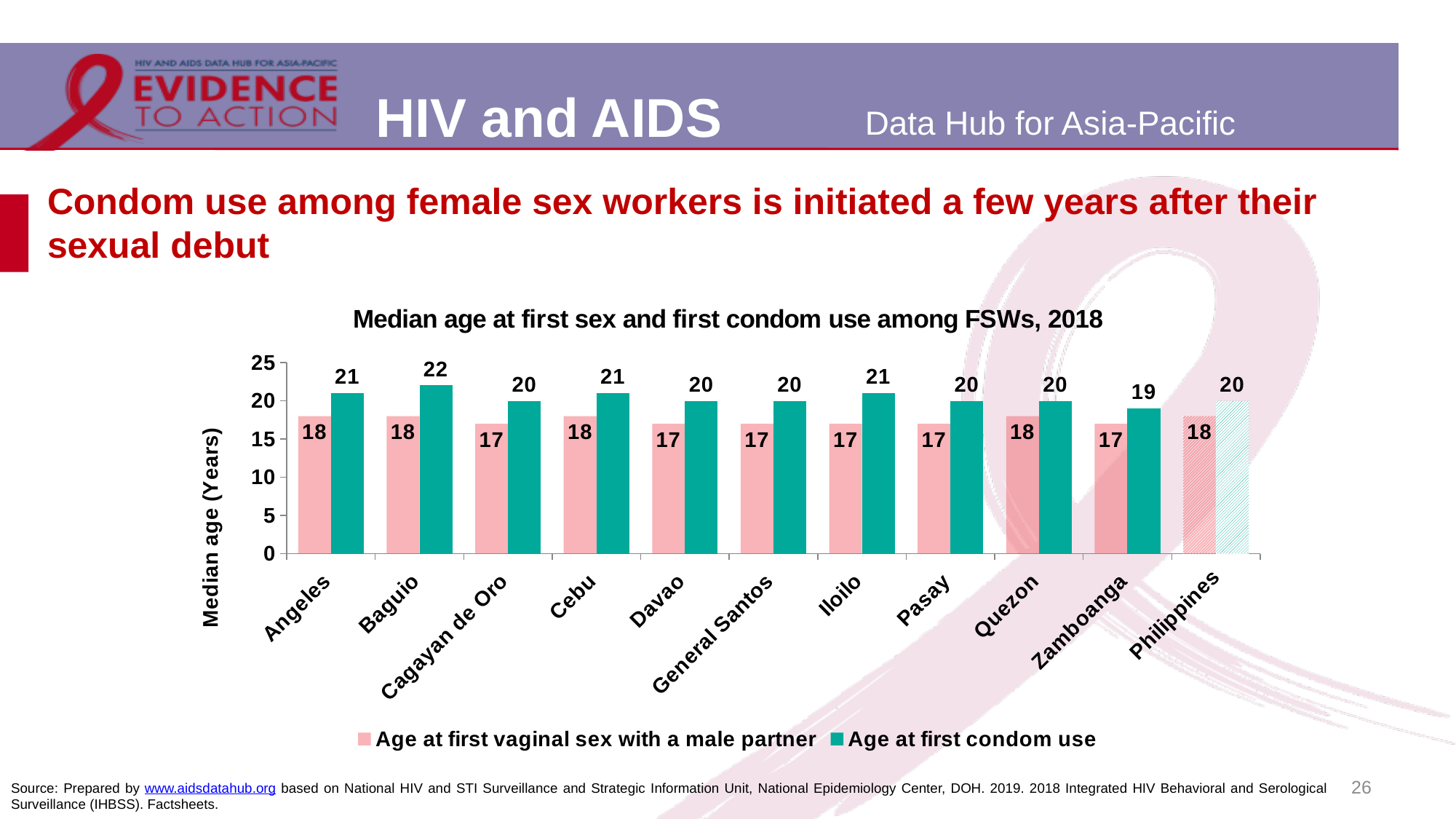
How many series does the legend list? 2 What is the median age at first condom use in Baguio? 22 What is the title of the chart? Median age at first sex and first condom use among FSWs, 2018 What is the median age at first vaginal sex with a male partner in Cagayan de Oro? 17 Which is larger: the median age at first condom use in Iloilo or in Zamboanga? Iloilo What type of chart is shown on the slide? Bar chart How many cities or areas are shown on the x axis of the chart? 11 What is the difference between the median age at first condom use and the median age at first vaginal sex for the Philippines? 2 What is the median age at first condom use for the Philippines overall? 20 What is the difference between the median age at first condom use and the median age at first vaginal sex in Baguio? 4 Which city has the highest median age at first condom use? Baguio Which city has the lowest median age at first condom use? Zamboanga